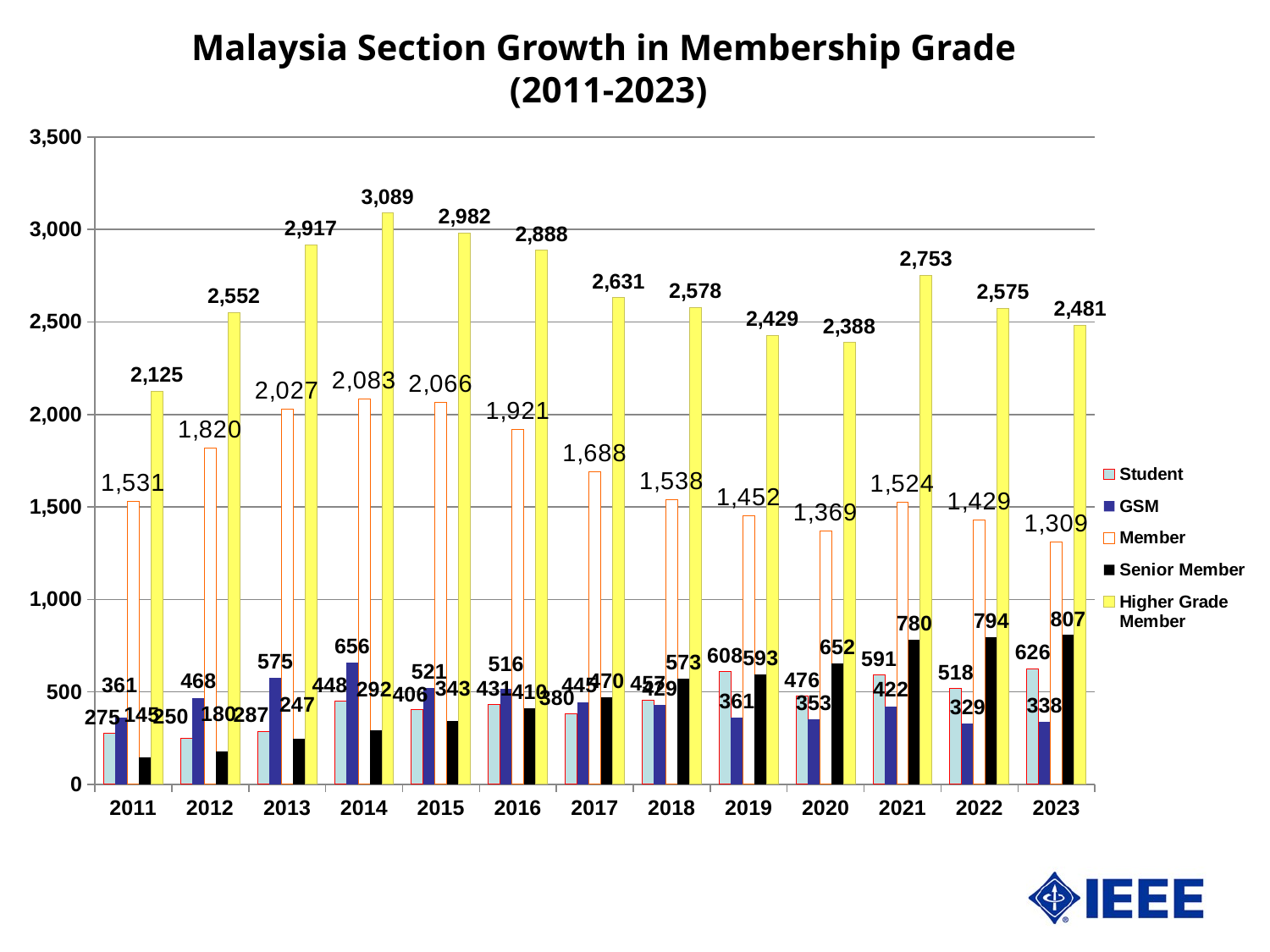
In which year is the Member value lowest? 2023 How many years are shown along the x axis? 13 What is the Senior Member value for 2023? 807 What is the Member value for 2011? 1,531 What kind of chart is shown on the slide? Bar chart In which year is the Higher Grade Member value highest? 2014 What is the title of the chart? Malaysia Section Growth in Membership Grade (2011-2023) What is the GSM value for 2014? 656 What is the difference between the Higher Grade Member values for 2014 and 2023? 608 How many series does the legend list? 5 Which is larger, the Student value for 2019 or the Student value for 2023? 2023 Do the Senior Member values rise or fall from 2011 to 2023? Rise